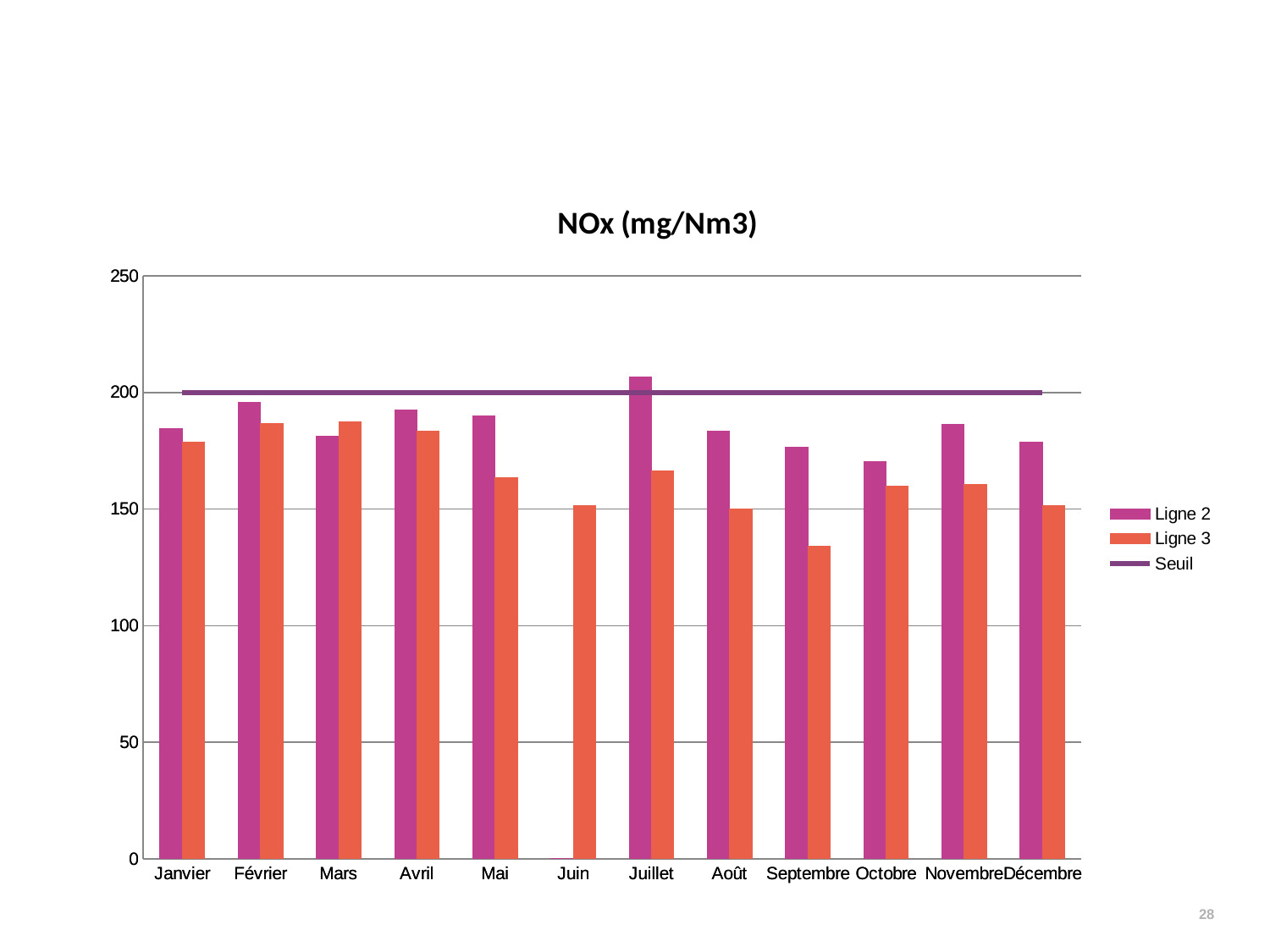
How many months are shown on the x axis? 12 In which month is the Ligne 2 value highest? Juillet Is the Ligne 2 value for Février greater or less than 200? less Which is the only month where the Ligne 2 bar exceeds the Seuil line? Juillet At what value is the Seuil line drawn? 200 In Mai, which series has the larger value, Ligne 2 or Ligne 3? Ligne 2 Is the Ligne 3 value for Septembre greater or less than 150? less Is the Ligne 2 value for Juillet greater or less than 200? greater What is the title of the chart? NOx (mg/Nm3) How many series does the legend list? 3 In which month is the Ligne 3 value lowest? Septembre What kind of chart is shown on the slide? bar chart